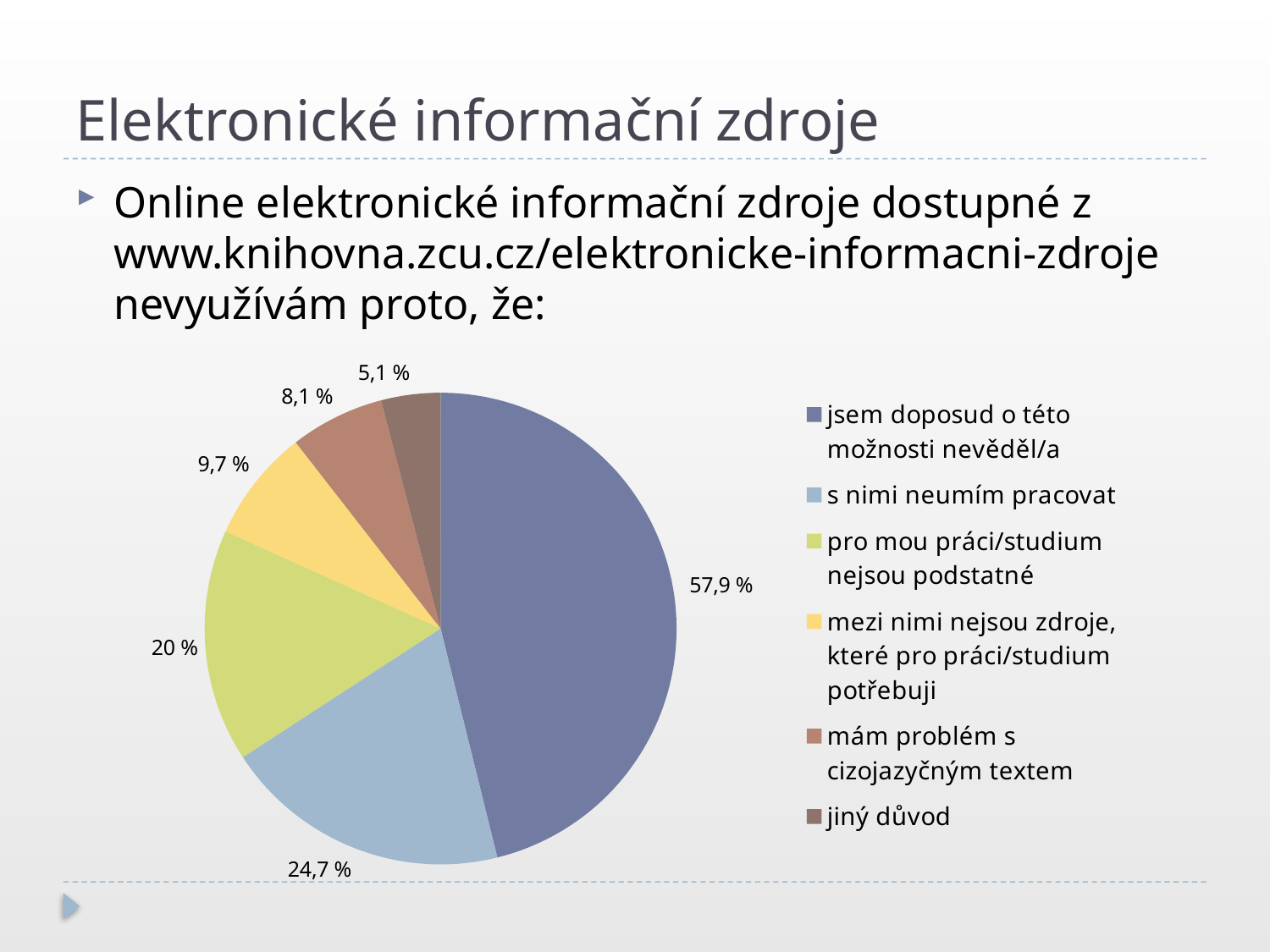
How many entries does the legend of the pie chart list? 6 Which category has the smallest slice in the pie chart? jiný důvod What percentage is shown for "s nimi neumím pracovat"? 24,7 % What kind of chart is shown on the slide? pie chart How many slices does the pie chart have? 6 What percentage is shown for "pro mou práci/studium nejsou podstatné"? 20 % What is the difference in percentage points between "s nimi neumím pracovat" and "mezi nimi nejsou zdroje, které pro práci/studium potřebuji"? 15 percentage points Which is larger: the slice for "pro mou práci/studium nejsou podstatné" or the slice for "mám problém s cizojazyčným textem"? pro mou práci/studium nejsou podstatné Which category has the largest slice in the pie chart? jsem doposud o této možnosti nevěděl/a What percentage is shown for "mám problém s cizojazyčným textem"? 8,1 % What percentage is shown for "jiný důvod"? 5,1 % What percentage is shown for "jsem doposud o této možnosti nevěděl/a"? 57,9 %